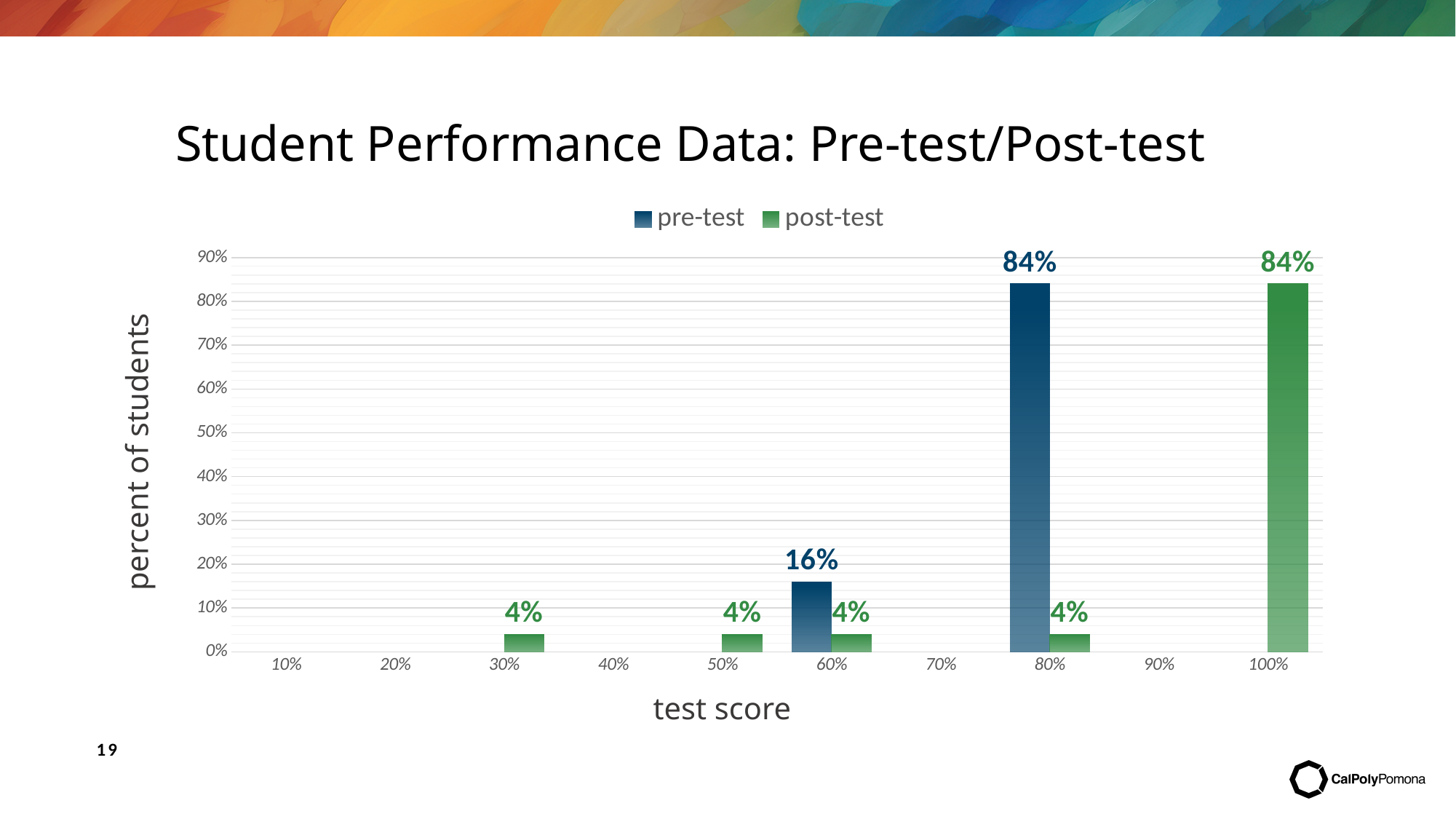
What is the difference between the pre-test value at 80% and the pre-test value at 60%? 68% At a test score of 60%, which series has the larger value, pre-test or post-test? pre-test What percent of students scored 30% on the post-test? 4% What is the difference between the pre-test and post-test values at a test score of 80%? 80% How many series does the legend list? 2 Which test score has the highest percent of students for the pre-test series? 80% What type of chart is shown on the slide? bar chart What percent of students scored 60% on the pre-test? 16% Which test score has the highest percent of students for the post-test series? 100% How many test score categories are shown on the x axis? 10 What percent of students scored 100% on the post-test? 84% What percent of students scored 80% on the pre-test? 84%